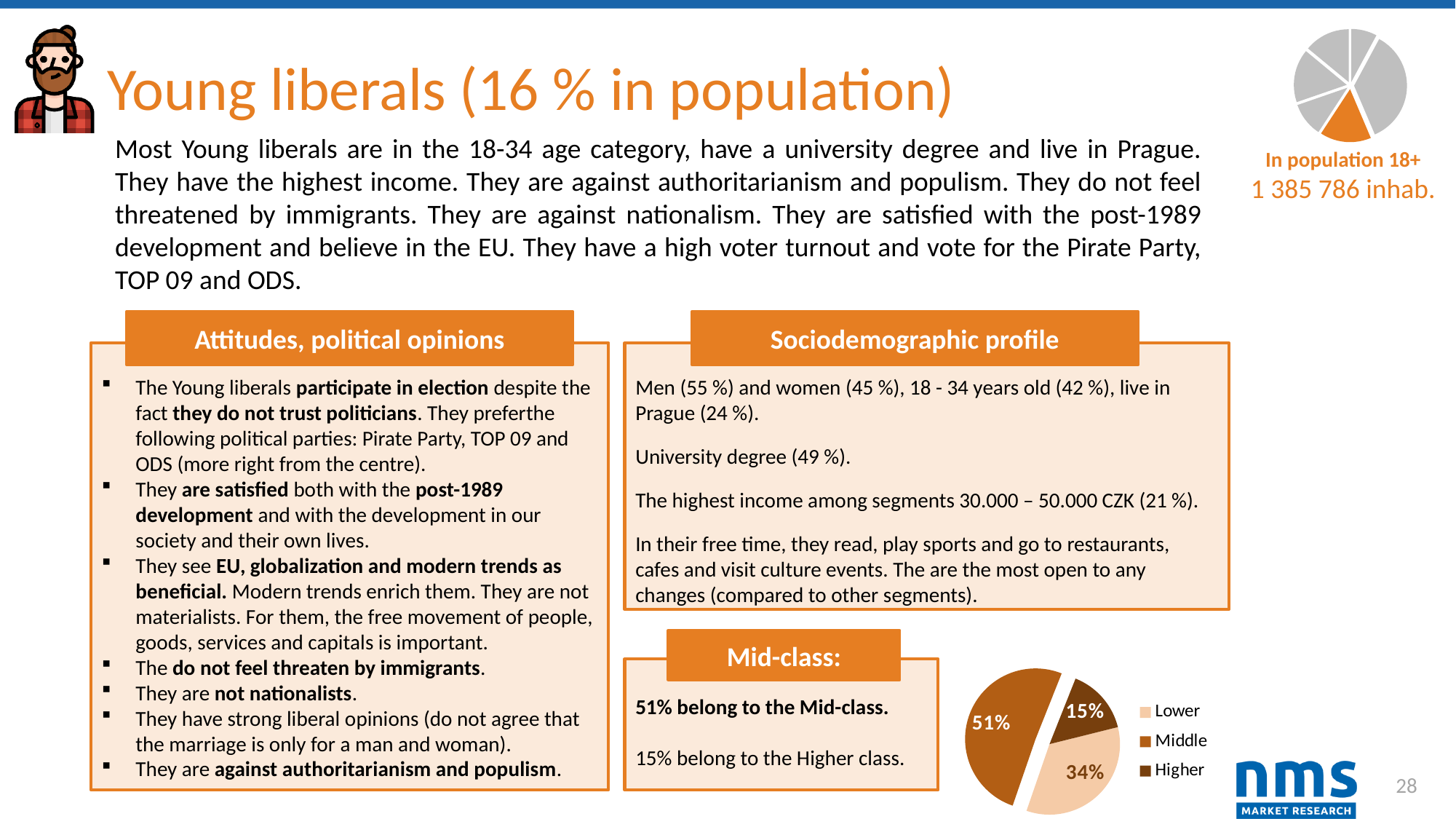
In the pie chart at the bottom right of the slide, what share belongs to the Higher class? 15% In the pie chart at the bottom right of the slide, which class has the largest slice? Middle In the pie chart at the bottom right of the slide, which class has the smallest slice? Higher In the pie chart at the bottom right of the slide, what share belongs to the Lower class? 34% How many entries does the legend of the pie chart at the bottom right of the slide list? 3 In the pie chart at the bottom right of the slide, what is the difference in percentage points between the Lower and Higher slices? 19 In the pie chart at the bottom right of the slide, which legend entry is shown in the darkest brown colour? Higher What type of chart is shown at the bottom right of the slide next to the Mid-class box? Pie chart In the pie chart at the bottom right of the slide, what share belongs to the Middle class? 51% How many slices does the pie chart at the bottom right of the slide have? 3 In the pie chart at the bottom right of the slide, what is the difference in percentage points between the Middle and Lower slices? 17 In the pie chart at the bottom right of the slide, which slice is larger: Lower or Higher? Lower